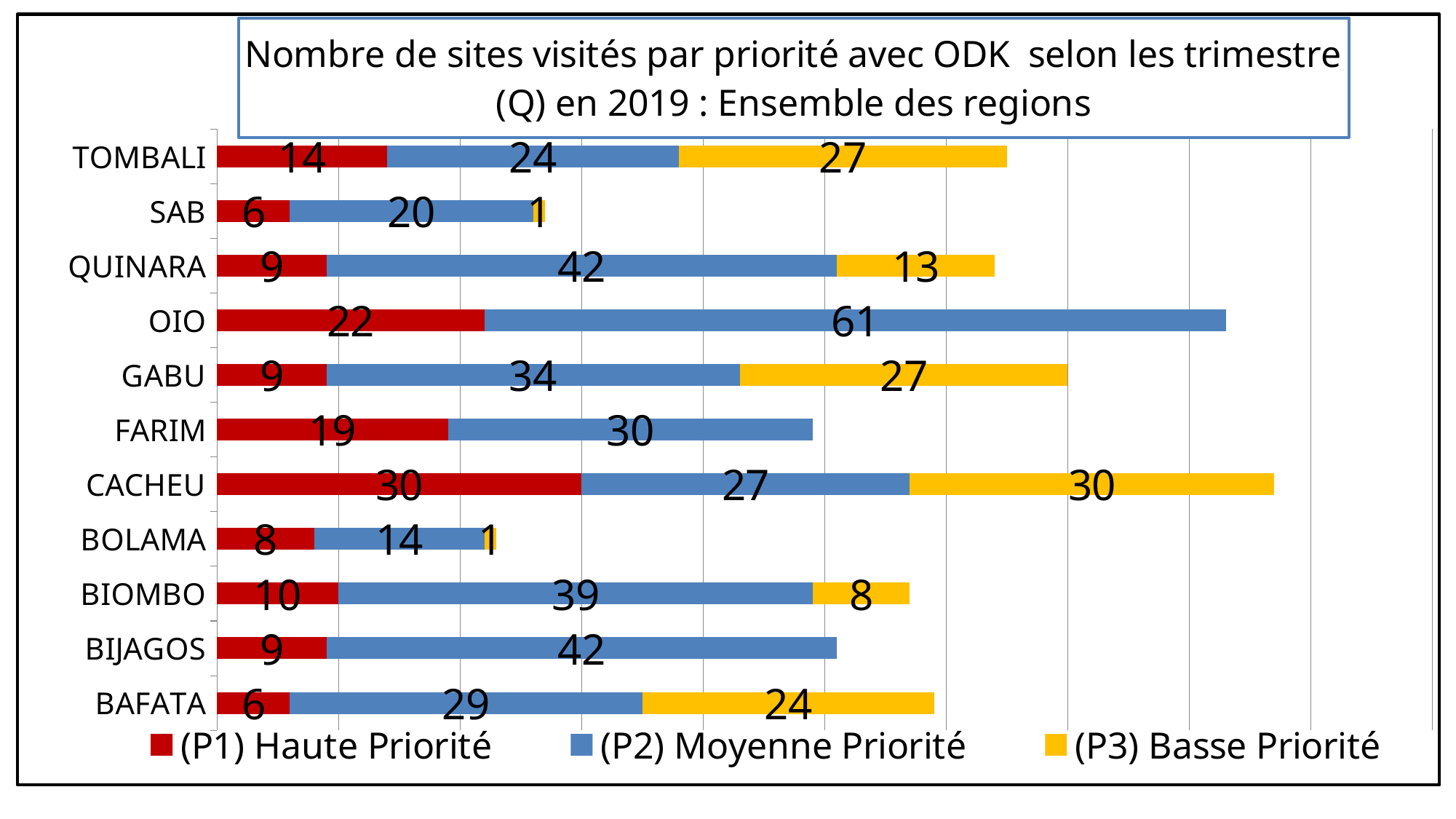
Which region has the highest (P1) Haute Priorité value? CACHEU Which region has the highest (P2) Moyenne Priorité value? OIO What is the (P3) Basse Priorité value for GABU? 27 What is the total number of sites for CACHEU across all three priorities? 87 What type of chart is shown on the slide? Stacked bar chart What is the (P1) Haute Priorité value for FARIM? 19 What is the (P2) Moyenne Priorité value for OIO? 61 How many regions are shown on the chart? 11 What is the difference between the (P2) Moyenne Priorité values for QUINARA and BIOMBO? 3 What is the total number of sites for TOMBALI across all three priorities? 65 How many series does the legend list? 3 Which is larger: the (P3) Basse Priorité value for BAFATA or for QUINARA? BAFATA